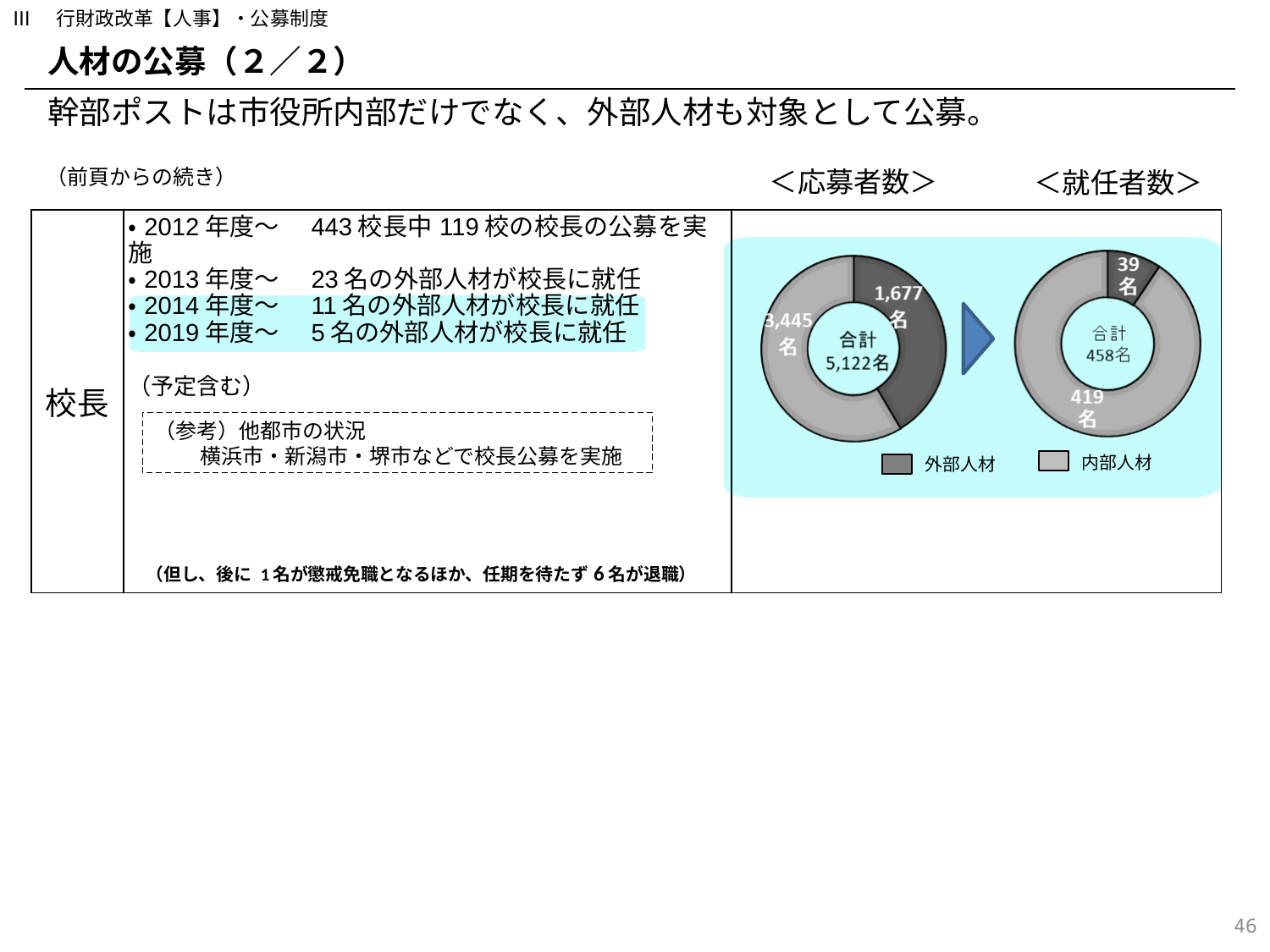
In the 応募者数 chart, which category is larger, 外部人材 or 内部人材? 内部人材 What kind of chart is used for 応募者数 and 就任者数? pie chart (donut) In the 応募者数 chart, what is the difference between 内部人材 and 外部人材? 1,768名 In the 就任者数 chart, what is the total (合計) shown in the centre? 458名 In the 就任者数 chart, what is the value for 外部人材? 39名 In the 応募者数 chart, what is the value for 外部人材? 1,677名 In the 応募者数 chart, what is the value for 内部人材? 3,445名 In the 応募者数 chart, what is the total (合計) shown in the centre? 5,122名 How many categories does the legend list for the two charts? 2 In the 就任者数 chart, what is the value for 内部人材? 419名 In the 就任者数 chart, what is the difference between 内部人材 and 外部人材? 380名 In the 就任者数 chart, which category is the smallest? 外部人材